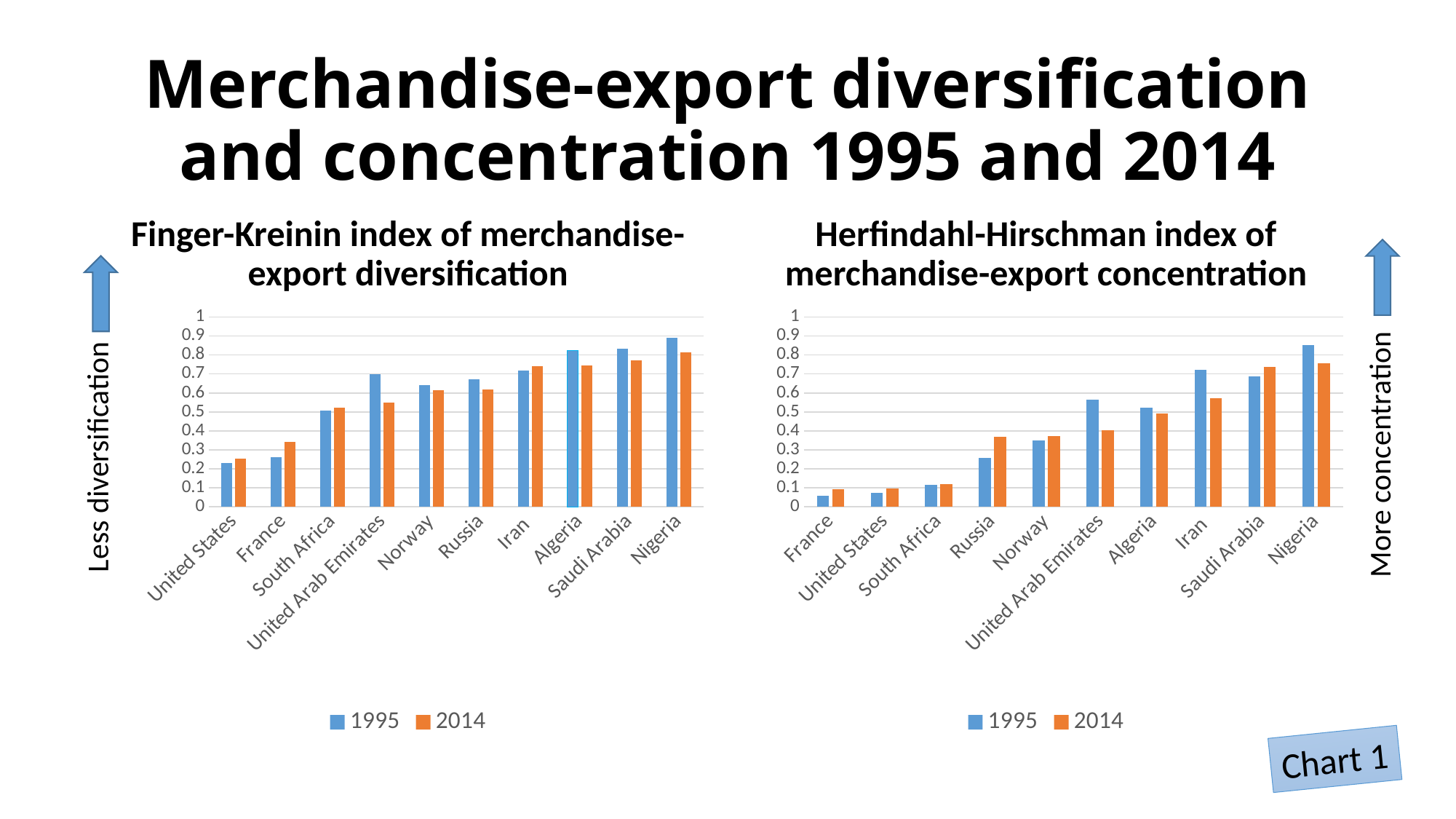
On the Finger-Kreinin index chart (left), is the 1995 value for United Arab Emirates greater or less than 0.6? greater How many countries are shown on the Herfindahl-Hirschman index chart (right)? 10 On the Finger-Kreinin index chart (left), which country has the highest value for 1995? Nigeria On the Finger-Kreinin index chart (left), which is larger for United Arab Emirates: the 1995 value or the 2014 value? 1995 On the Finger-Kreinin index chart (left), which country has the lowest value for 2014? United States What are the two legend entries on the Herfindahl-Hirschman index chart (right)? 1995 and 2014 What kind of chart is the Herfindahl-Hirschman index chart (right)? bar chart On the Herfindahl-Hirschman index chart (right), which country has the highest value for 1995? Nigeria On the Herfindahl-Hirschman index chart (right), which is larger for Iran: the 1995 value or the 2014 value? 1995 How many countries are shown on the Finger-Kreinin index chart (left)? 10 How many series does the legend of the Finger-Kreinin index chart (left) list? 2 On the Herfindahl-Hirschman index chart (right), is the 1995 value for Iran greater or less than 0.6? greater